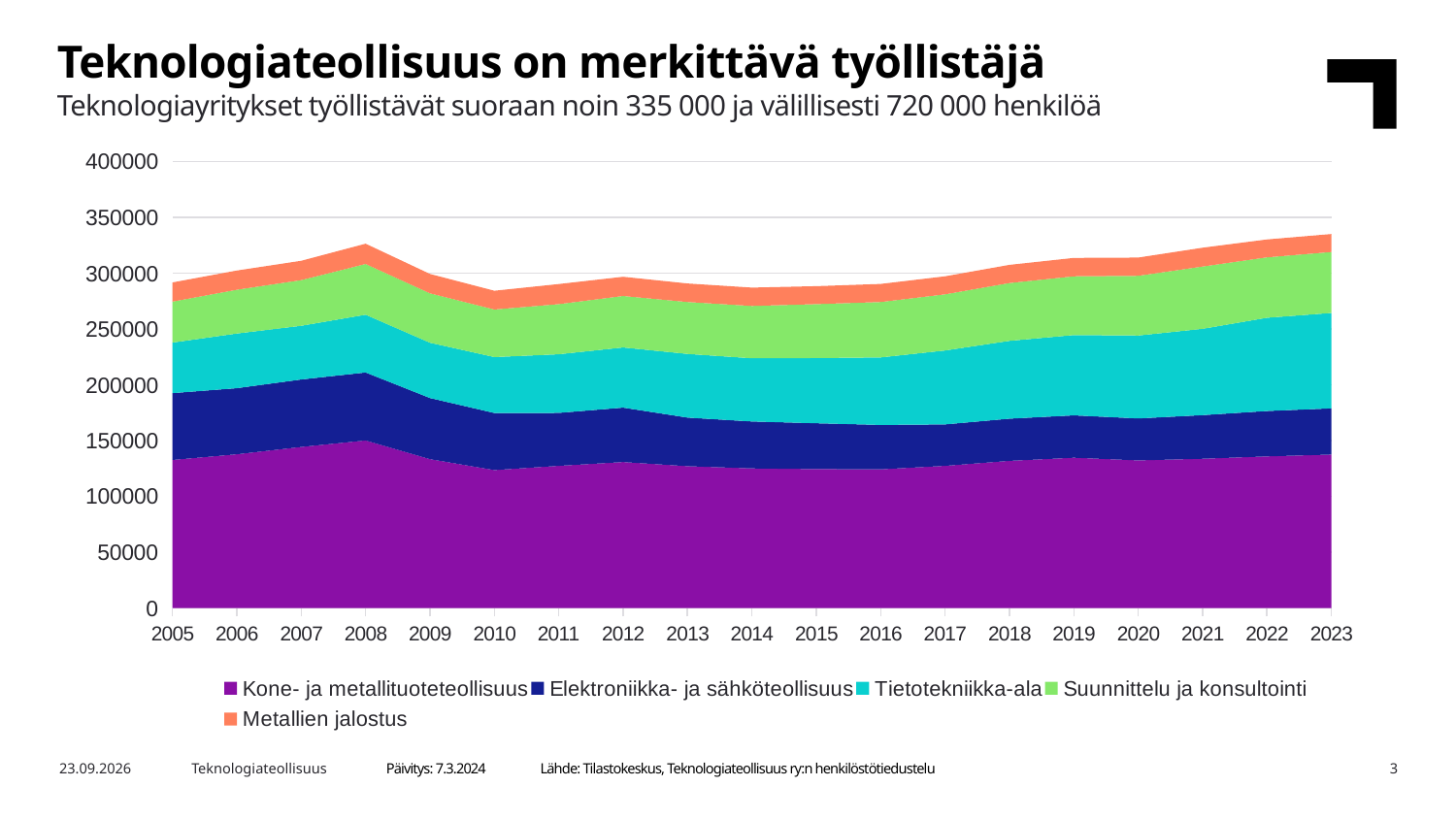
Does the Tietotekniikka-ala band grow or shrink from 2005 to 2023? grow How many series does the legend list? 5 What is the first year shown on the x axis? 2005 How many years are shown along the x axis? 19 Which series accounts for the largest share of employment across the years shown? Kone- ja metallituoteteollisuus Which series accounts for the smallest share of employment across the years shown? Metallien jalostus Is the value for Kone- ja metallituoteteollisuus in 2005 greater or less than 150000? less Is the total stacked value for 2023 greater or less than 300000? greater Is the total stacked value for 2010 greater or less than 300000? less Is the value for Kone- ja metallituoteteollisuus larger in 2008 or in 2010? 2008 What kind of chart is shown on the slide? Stacked area chart Which series is plotted as the bottom (purple) band of the chart? Kone- ja metallituoteteollisuus